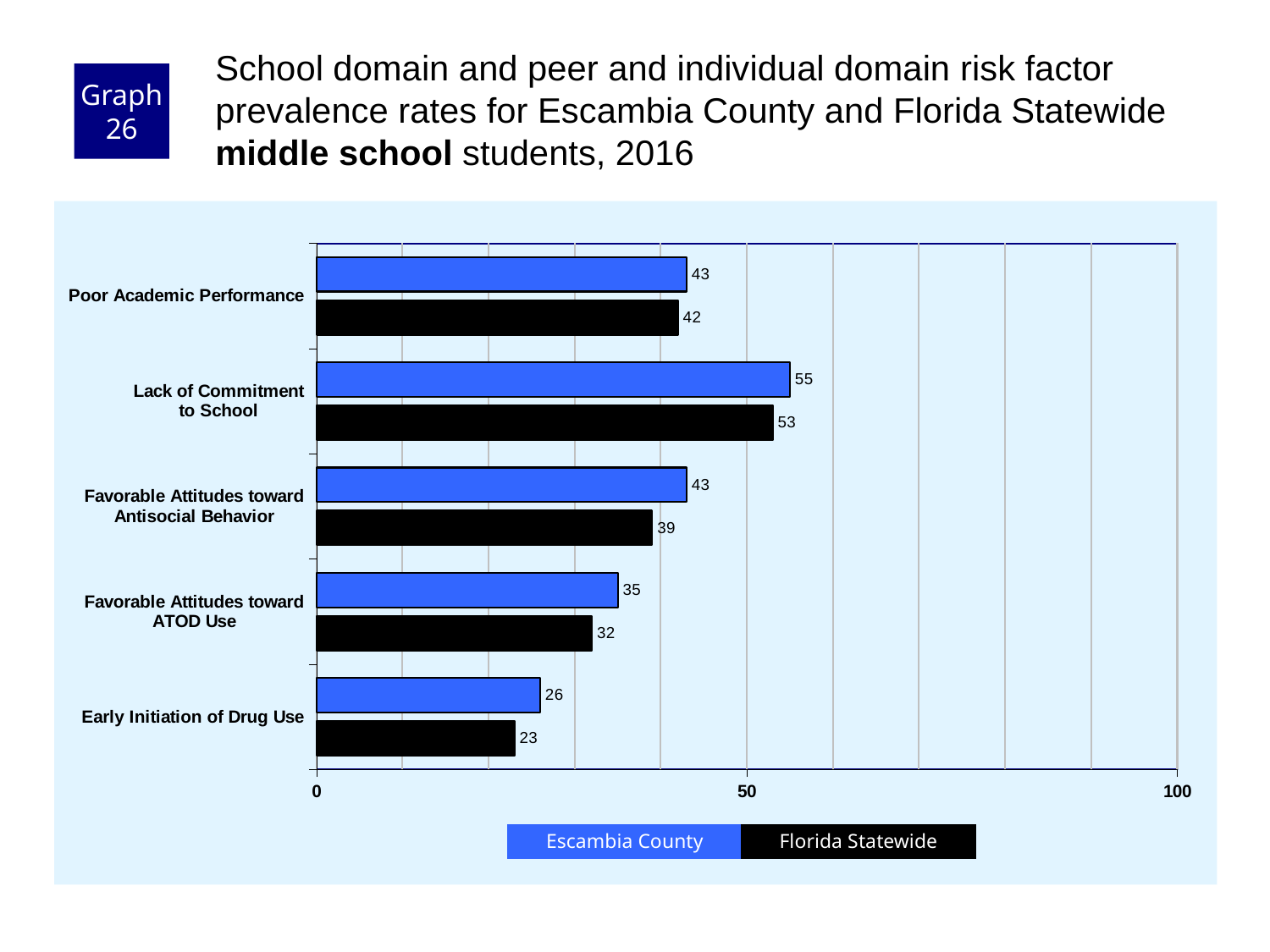
Which is larger for Favorable Attitudes toward ATOD Use: Escambia County or Florida Statewide? Escambia County Which risk factor has the highest Escambia County value? Lack of Commitment to School What is the Florida Statewide value for Favorable Attitudes toward Antisocial Behavior? 39 What is the Florida Statewide value for Early Initiation of Drug Use? 23 What kind of chart is shown on the slide? bar chart How many risk factor categories are shown on the chart? 5 Which colour represents Florida Statewide in the chart? black Is the Escambia County value for Lack of Commitment to School greater or less than 50? greater How many series does the legend list? 2 What is the Escambia County value for Lack of Commitment to School? 55 What is the difference between the Escambia County and Florida Statewide values for Favorable Attitudes toward Antisocial Behavior? 4 Which risk factor has the lowest Florida Statewide value? Early Initiation of Drug Use